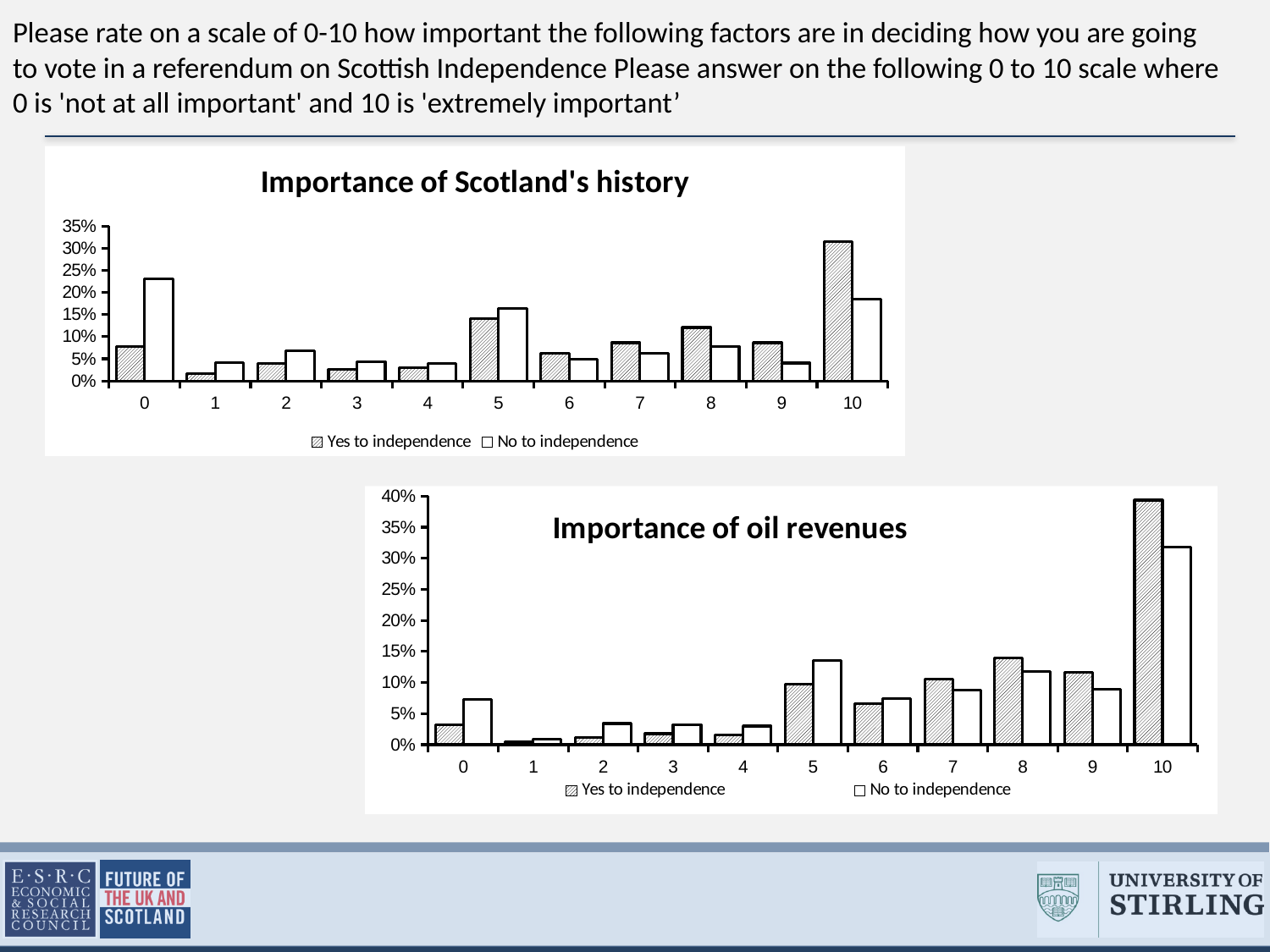
In the 'Importance of oil revenues' chart, is the 'Yes to independence' value for rating 10 greater or less than 35%? greater In the 'Importance of oil revenues' chart, is the 'No to independence' value for rating 5 greater or less than 10%? greater In the 'Importance of Scotland's history' chart, which is larger at rating 5: 'Yes to independence' or 'No to independence'? No to independence In the 'Importance of Scotland's history' chart, which rating has the highest value for 'No to independence'? 0 How many series does the legend of the 'Importance of oil revenues' chart list? 2 How many rating categories are shown on the x axis of the 'Importance of Scotland's history' chart? 11 In the 'Importance of Scotland's history' chart, is the 'Yes to independence' value for rating 10 greater or less than 30%? greater In the 'Importance of oil revenues' chart, which is larger at rating 0: 'Yes to independence' or 'No to independence'? No to independence In the 'Importance of oil revenues' chart, which rating has the lowest value for 'Yes to independence'? 1 What kind of chart is 'Importance of oil revenues'? Bar chart In the 'Importance of Scotland's history' chart, which rating has the highest value for 'Yes to independence'? 10